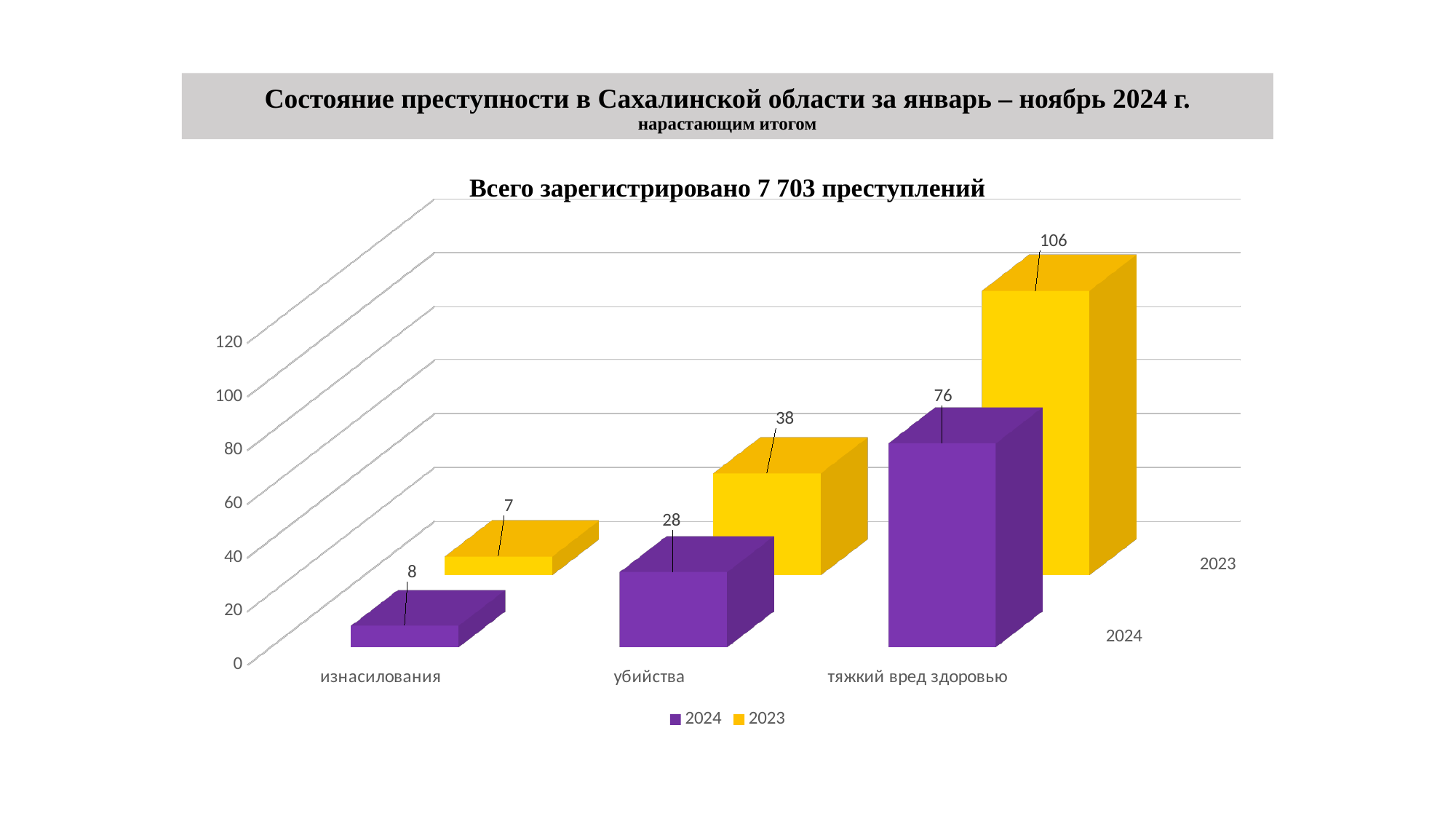
What is the difference between the 2023 and 2024 values for убийства? 10 Which category has the lowest value in the 2024 series? изнасилования What is the difference between the 2023 and 2024 values for тяжкий вред здоровью? 30 How many series does the legend list? 2 Which category has the highest value in the 2023 series? тяжкий вред здоровью What kind of chart is shown on the slide? bar chart What is the value for изнасилования in the 2023 series? 7 What is the value for тяжкий вред здоровью in the 2024 series? 76 What is the value for убийства in the 2024 series? 28 Which is larger for изнасилования: the 2024 value or the 2023 value? 2024 What is the value for тяжкий вред здоровью in the 2023 series? 106 How many categories are shown on the x axis? 3